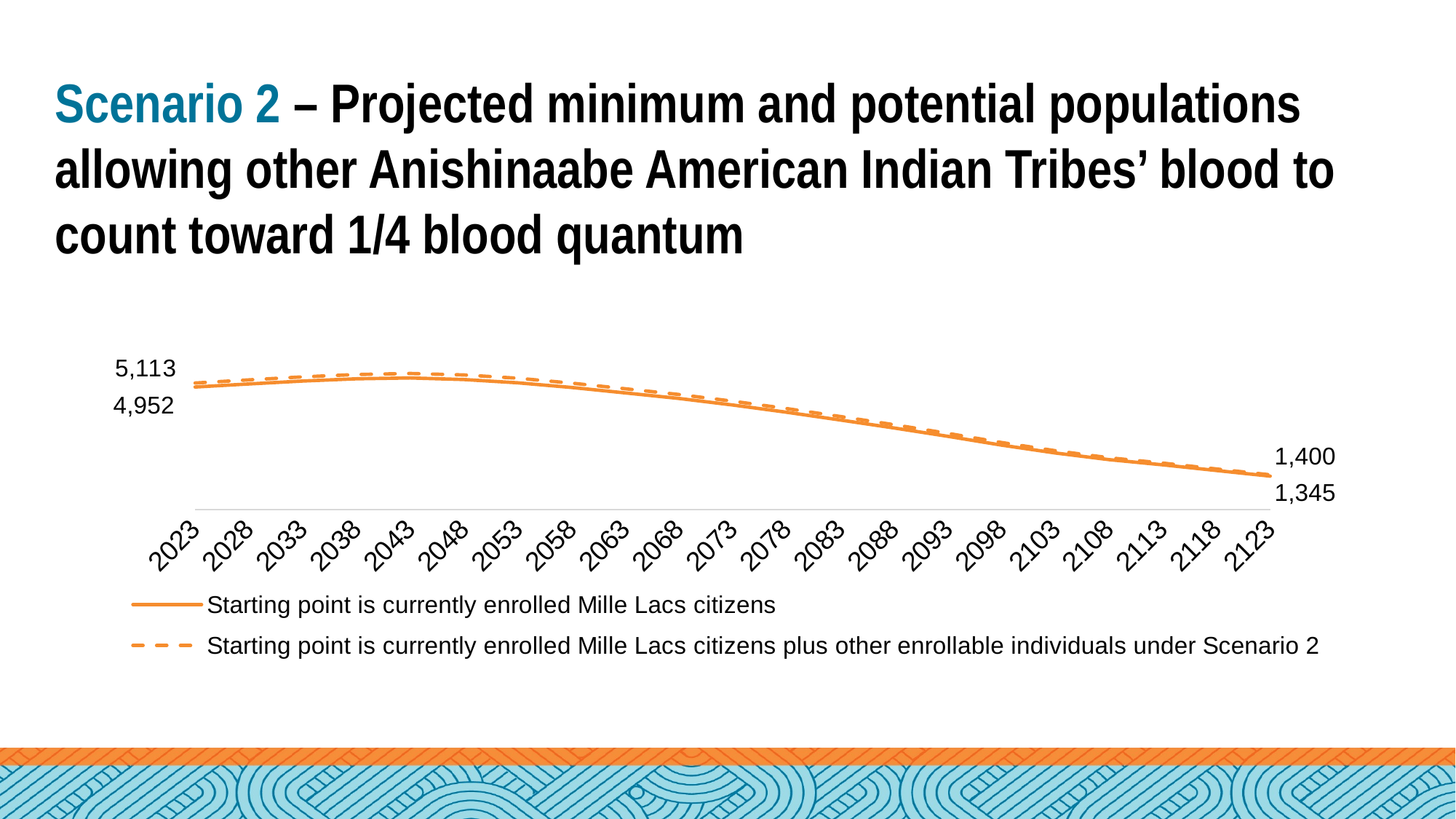
Overall, do the plotted values rise or fall from 2023 to 2123? fall What is the 2023 value for the series 'Starting point is currently enrolled Mille Lacs citizens plus other enrollable individuals under Scenario 2'? 5,113 What is the 2023 value for the series 'Starting point is currently enrolled Mille Lacs citizens'? 4,952 What kind of chart is shown on the slide? line chart What is the difference between the two series' values in 2123? 55 Which series has the higher value in 2123? Starting point is currently enrolled Mille Lacs citizens plus other enrollable individuals under Scenario 2 What is the 2123 value for the series 'Starting point is currently enrolled Mille Lacs citizens plus other enrollable individuals under Scenario 2'? 1,400 What is the difference between the two series' values in 2023? 161 How many years are labelled along the x axis? 21 How many series does the legend list? 2 By how much does the 'Starting point is currently enrolled Mille Lacs citizens' series decline from 2023 to 2123? 3,607 What is the 2123 value for the series 'Starting point is currently enrolled Mille Lacs citizens'? 1,345